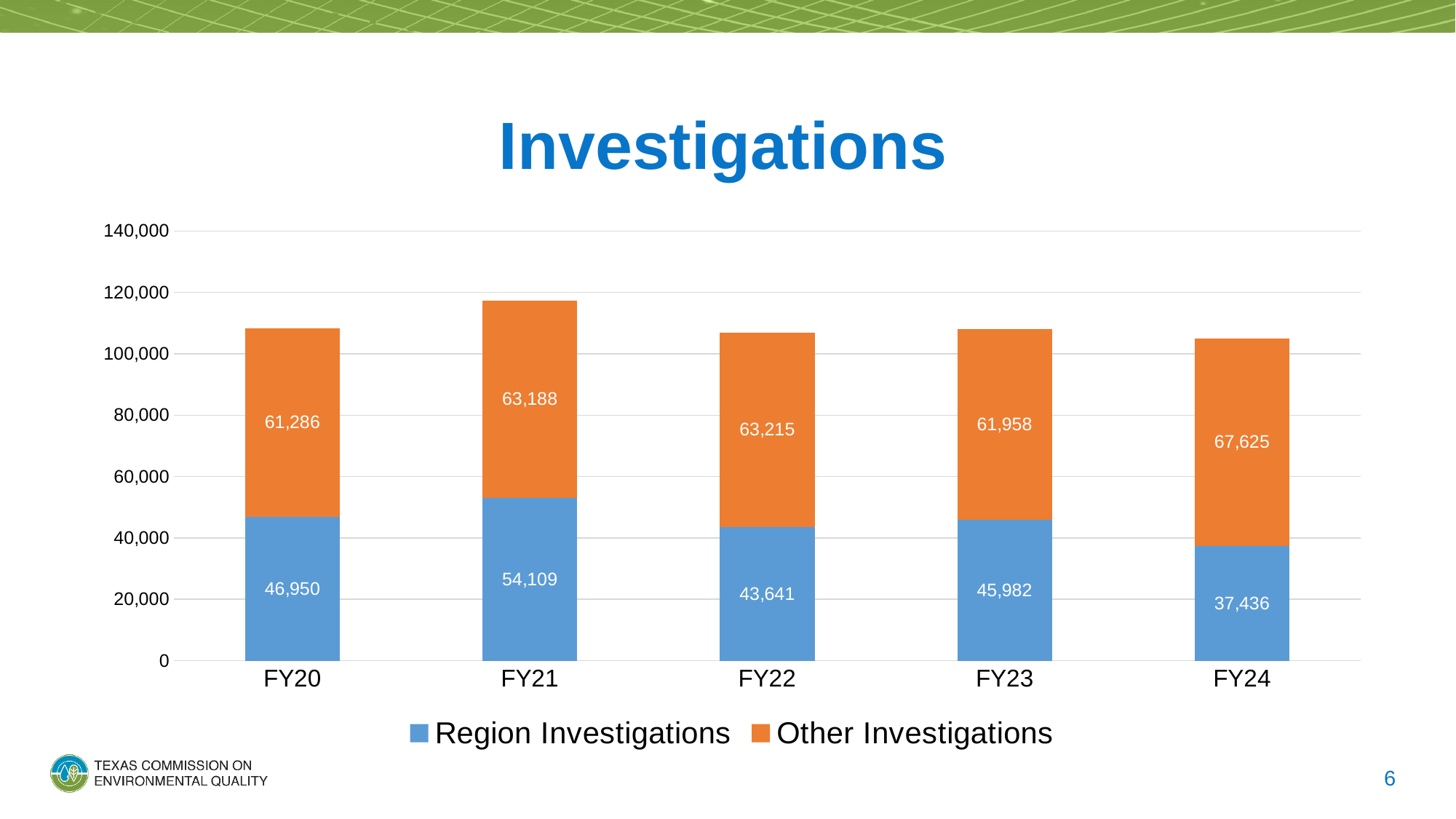
What is the difference between Region Investigations in FY21 and FY24? 16,673 What kind of chart is shown on the slide? Stacked bar chart What is the value for Region Investigations in FY21? 54,109 Which fiscal year has the highest value for Other Investigations? FY24 Which fiscal year has the highest value for Region Investigations? FY21 Which fiscal year has the lowest value for Region Investigations? FY24 How many series does the legend list? 2 How many fiscal years are shown on the x axis? 5 What is the value for Other Investigations in FY24? 67,625 Which is larger: Other Investigations in FY22 or Other Investigations in FY23? Other Investigations in FY22 What is the total of the stacked bar for FY21? 117,297 What is the value for Region Investigations in FY22? 43,641